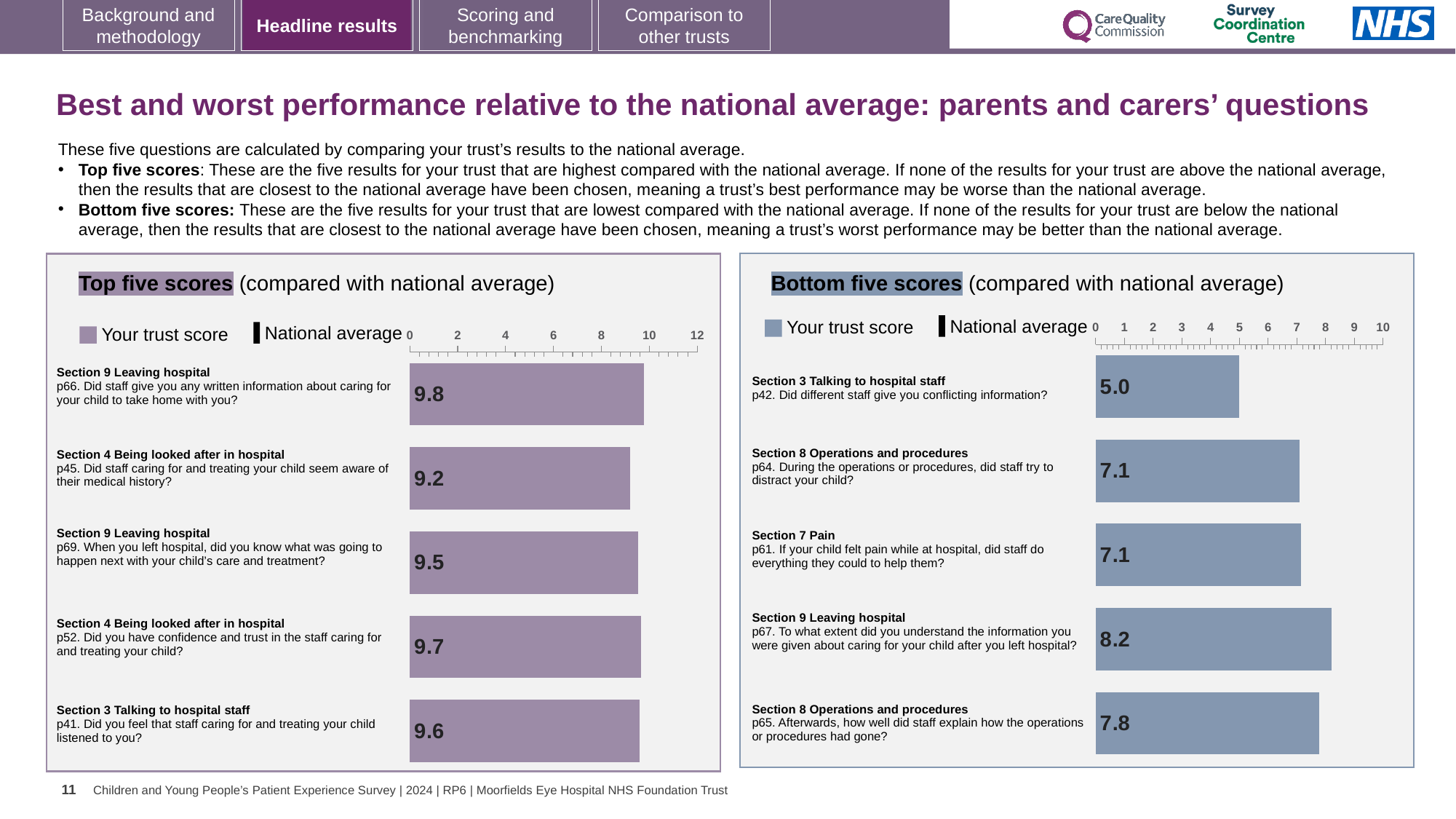
In the Bottom five scores chart, which has the larger trust score: p65 or p64? p65 In the Bottom five scores chart, is the trust score for p42 greater or less than 6? less In the Bottom five scores chart, which question has the highest trust score? p67 (Section 9 Leaving hospital) What kind of chart is the Bottom five scores chart? Bar chart In the Top five scores chart, what is the difference between the trust scores for p66 and p45? 0.6 In the Bottom five scores chart, which question has the lowest trust score? p42 (Section 3 Talking to hospital staff) In the Bottom five scores chart, what is the trust score for p42 (Did different staff give you conflicting information?)? 5.0 In the Top five scores chart, which question has the lowest trust score? p45 (Section 4 Being looked after in hospital) In the Top five scores chart, which question has the highest trust score? p66 (Section 9 Leaving hospital) How many questions are plotted in the Top five scores chart? 5 In the Bottom five scores chart, what is the difference between the trust scores for p67 and p42? 3.2 In the Top five scores chart, what is the trust score for p66 (Did staff give you any written information about caring for your child to take home with you?)? 9.8